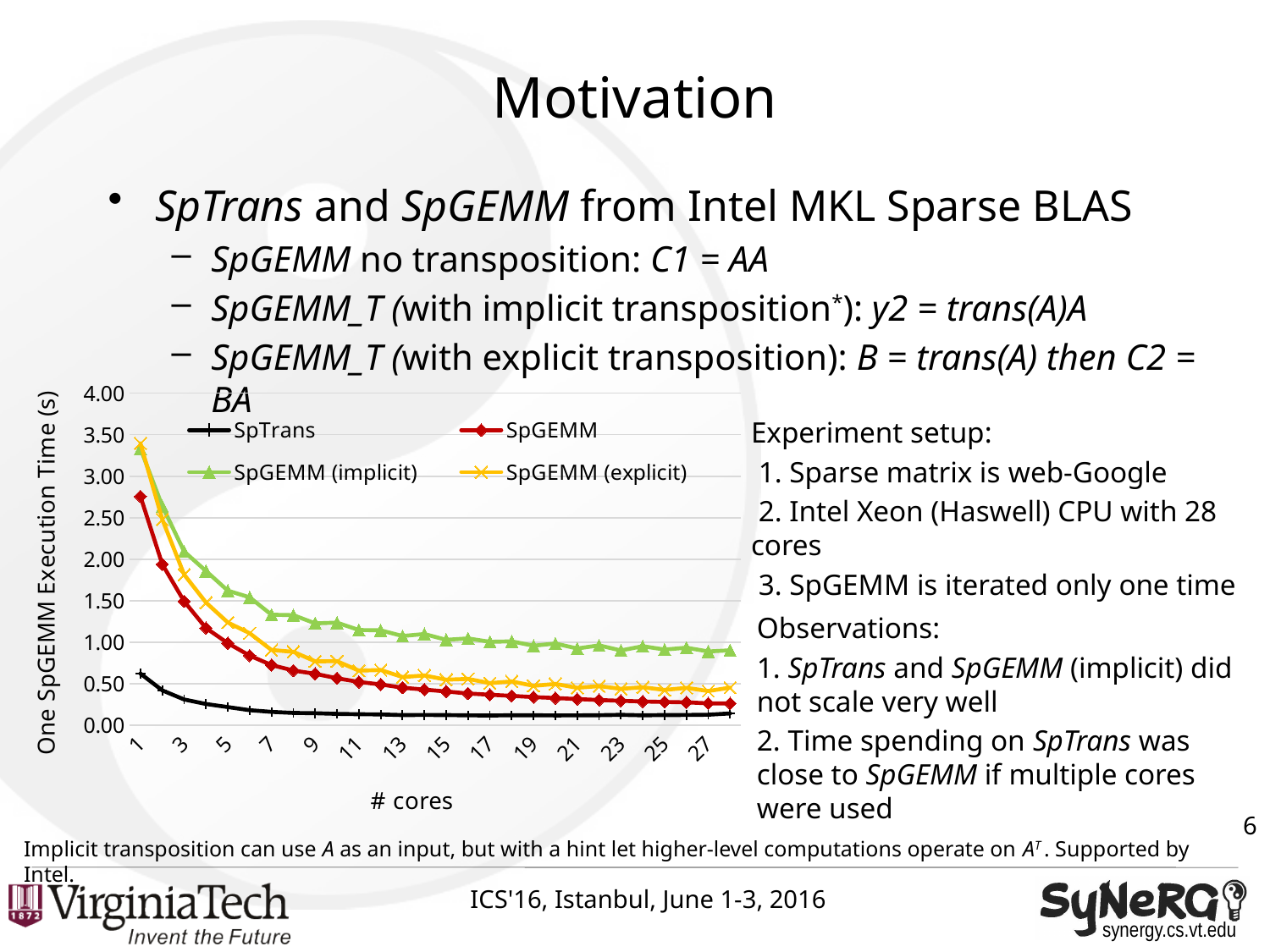
Is the value for SpGEMM (implicit) at 27 cores greater or less than 1.00? less At 1 core, which is larger: the value for SpGEMM (implicit) or the value for SpGEMM? SpGEMM (implicit) Is the value for SpGEMM (implicit) at 1 core greater or less than 3.00? greater Do the execution times rise or fall as the number of cores increases? fall Is the value for SpTrans at 1 core greater or less than 0.50? greater What kind of chart is shown on the slide? line chart How many series does the chart legend list? 4 What is the label of the chart's x axis? # cores What is the label of the chart's y axis? One SpGEMM Execution Time (s) Which series has the lowest execution time across the number of cores? SpTrans